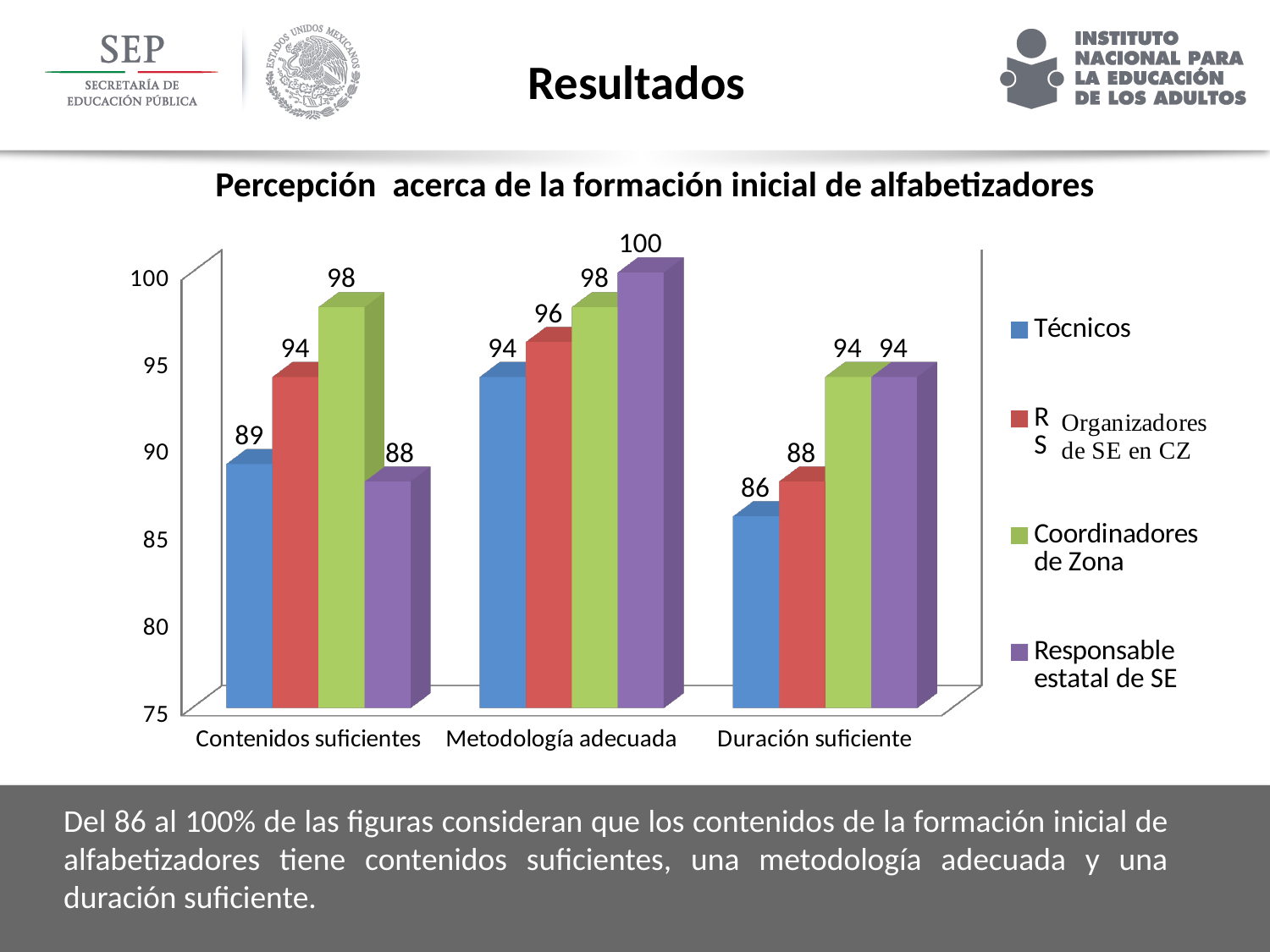
What is the difference between the Coordinadores de Zona value and the Técnicos value in the Contenidos suficientes category? 9 Which series has the lowest value in the Contenidos suficientes category? Responsable estatal de SE What is the value for Técnicos in the Contenidos suficientes category? 89 What type of chart is shown on the slide? Bar chart What is the title of the chart? Percepción acerca de la formación inicial de alfabetizadores How many categories are shown on the x axis? 3 What is the value for Responsable estatal de SE in the Metodología adecuada category? 100 Which is larger: the Técnicos value for Metodología adecuada or the Técnicos value for Duración suficiente? Metodología adecuada What is the value for Coordinadores de Zona in the Duración suficiente category? 94 What is the value for Técnicos in the Duración suficiente category? 86 How many series does the legend list? 4 Which series has the highest value in the Metodología adecuada category? Responsable estatal de SE